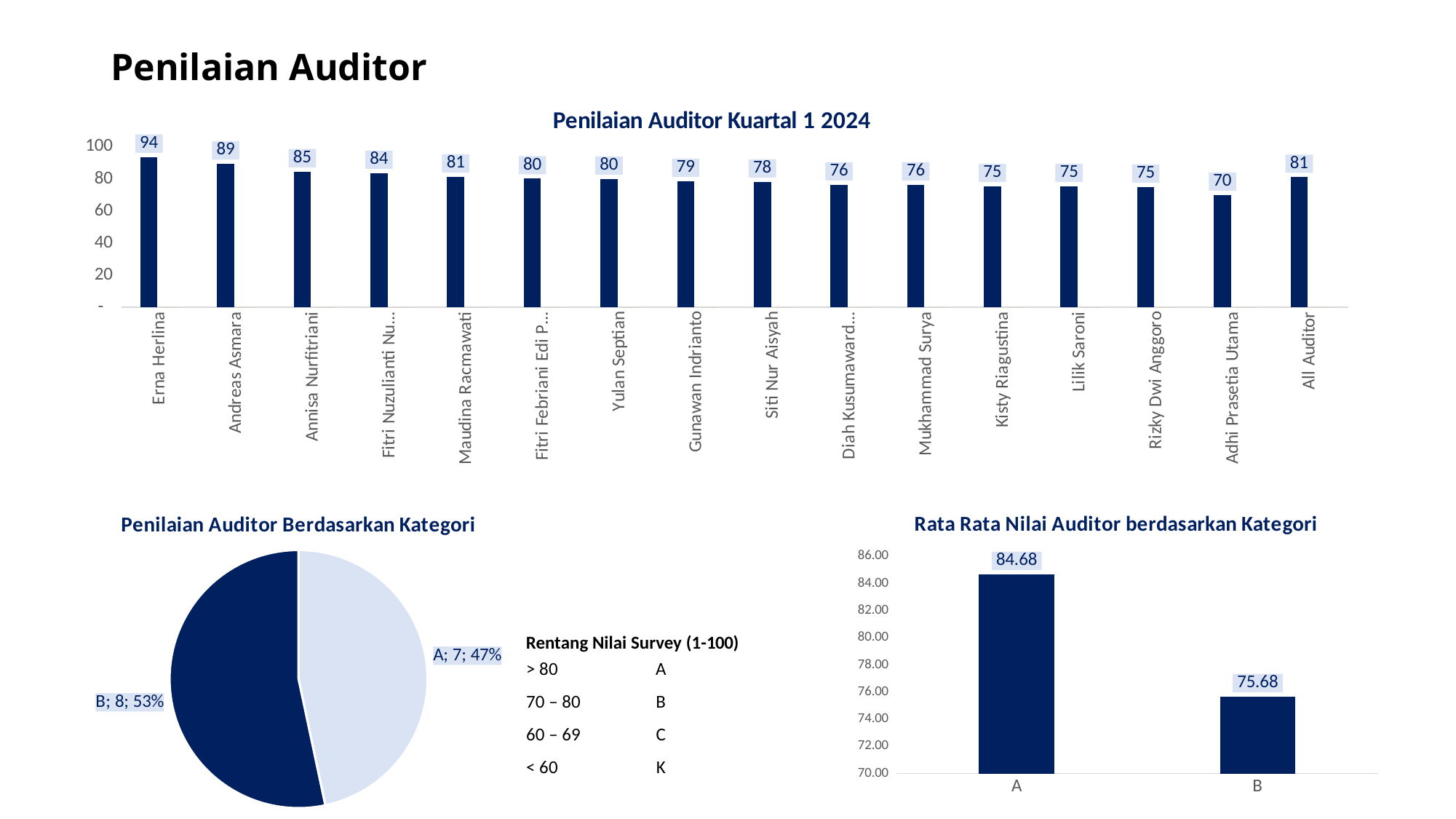
In the 'Penilaian Auditor Kuartal 1 2024' chart, what is the difference between Erna Herlina and Andreas Asmara? 5 In the 'Penilaian Auditor Kuartal 1 2024' chart, what is the value for Erna Herlina? 94 In the 'Penilaian Auditor Kuartal 1 2024' chart, which is larger, the value for Siti Nur Aisyah or the value for Gunawan Indrianto? Gunawan Indrianto In the 'Rata Rata Nilai Auditor berdasarkan Kategori' chart, what is the difference between category A and category B? 9.00 What type of chart is 'Penilaian Auditor Kuartal 1 2024'? Bar chart In the 'Penilaian Auditor Berdasarkan Kategori' pie chart, what share does category B have? 53% In the 'Penilaian Auditor Berdasarkan Kategori' pie chart, how many auditors are in category A? 7 In the 'Penilaian Auditor Kuartal 1 2024' chart, which auditor has the highest value? Erna Herlina In the 'Rata Rata Nilai Auditor berdasarkan Kategori' chart, what is the value for category A? 84.68 In the 'Penilaian Auditor Kuartal 1 2024' chart, which auditor has the lowest value? Adhi Prasetia Utama In the 'Penilaian Auditor Kuartal 1 2024' chart, what is the value for All Auditor? 81 How many bars are shown in the 'Penilaian Auditor Kuartal 1 2024' chart? 16